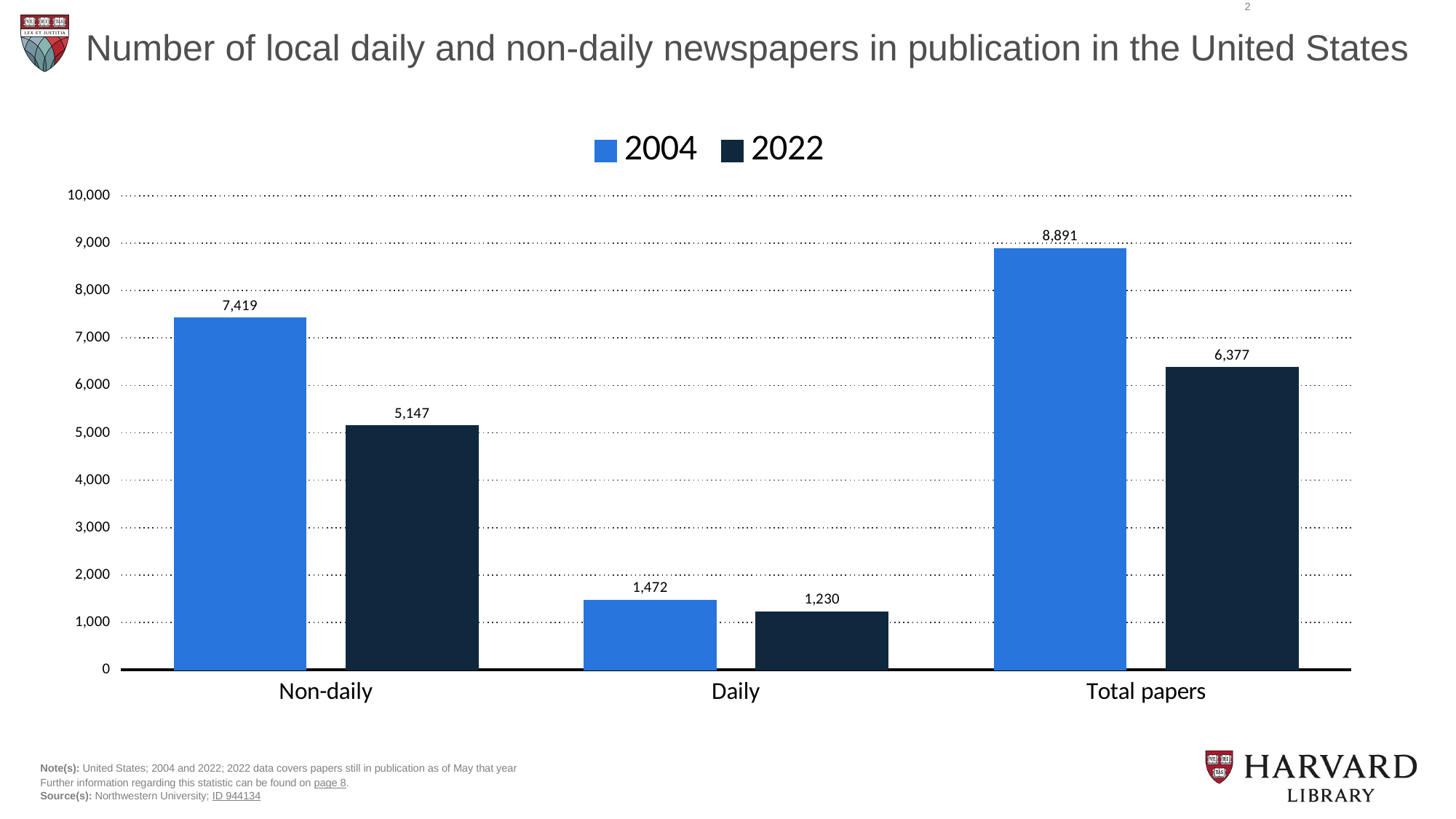
Is the 2022 value for Non-daily greater or less than 6,000? less What is the difference between the 2004 and 2022 values for Total papers? 2,514 What is the difference between the 2004 and 2022 values for Non-daily newspapers? 2,272 Which is larger, the 2004 value for Daily or the 2022 value for Daily? 2004 Which category has the highest value in 2004? Total papers How many categories are shown on the x axis? 3 How many series does the legend list? 2 What is the value for Daily newspapers in 2022? 1,230 What is the value for Non-daily newspapers in 2004? 7,419 What kind of chart is shown on the slide? Bar chart What is the value for Total papers in 2004? 8,891 Which category has the lowest value in 2022? Daily